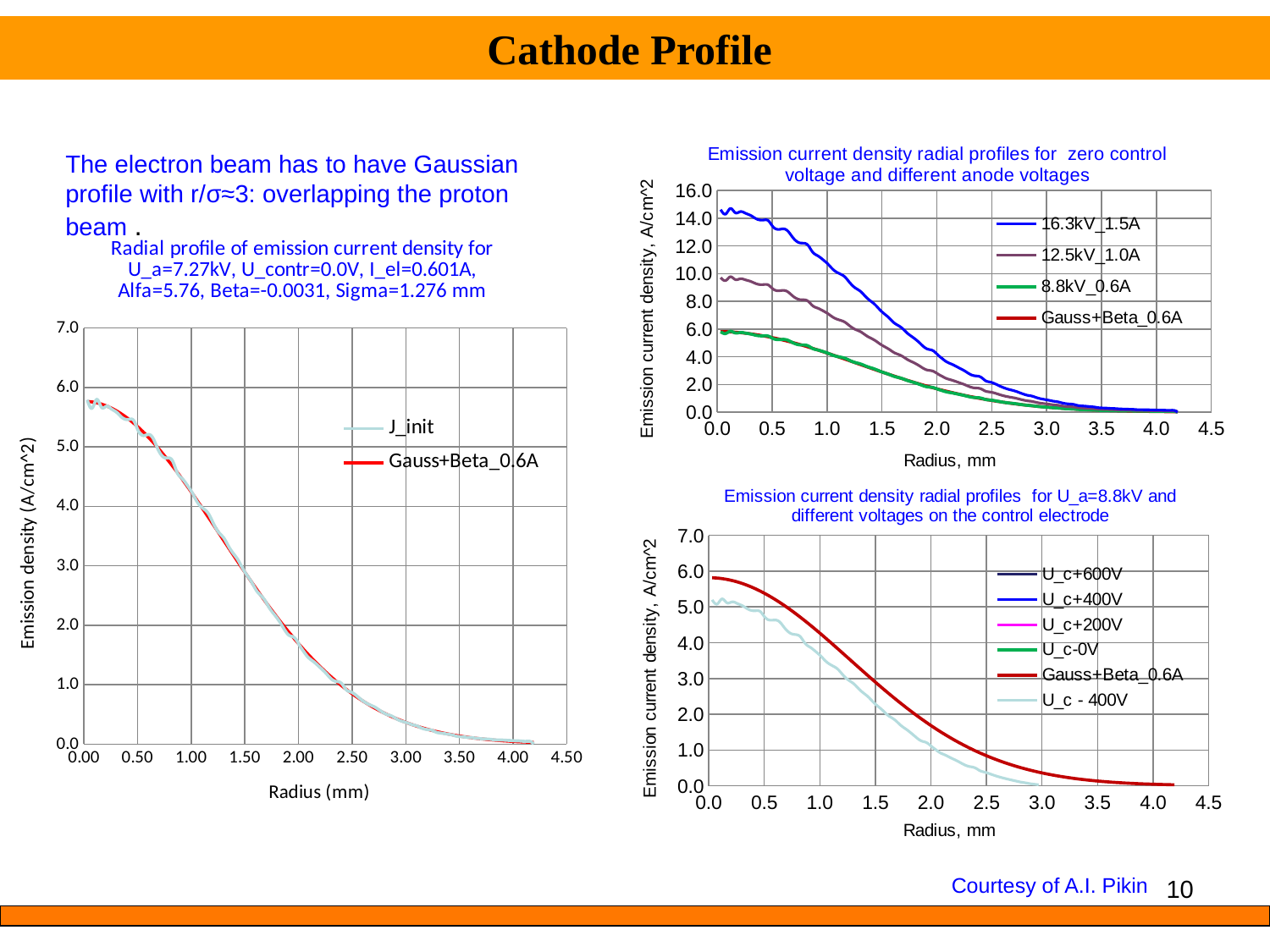
How many series does the legend of the bottom-right chart (U_a=8.8kV and different voltages on the control electrode) list? 6 What is the x-axis label of the top-right chart (different anode voltages)? Radius, mm In the left chart, do the values rise or fall as the radius increases? Fall In the top-right chart (different anode voltages), is the value of 8.8kV_0.6A at radius 0.0 mm greater or less than 8.0? less How many series does the legend of the left chart list? 2 In the top-right chart (different anode voltages), which series has the highest emission current density at radius 0.0 mm? 16.3kV_1.5A In the left chart, is the value of Gauss+Beta_0.6A at radius 1.00 mm greater or less than 4.0? greater What kind of chart is the left chart titled 'Radial profile of emission current density for U_a=7.27kV...'? Line chart In the bottom-right chart (different control electrode voltages), is the value of U_c - 400V at radius 2.0 mm greater or less than 2.0? less How many series does the legend of the top-right chart (zero control voltage and different anode voltages) list? 4